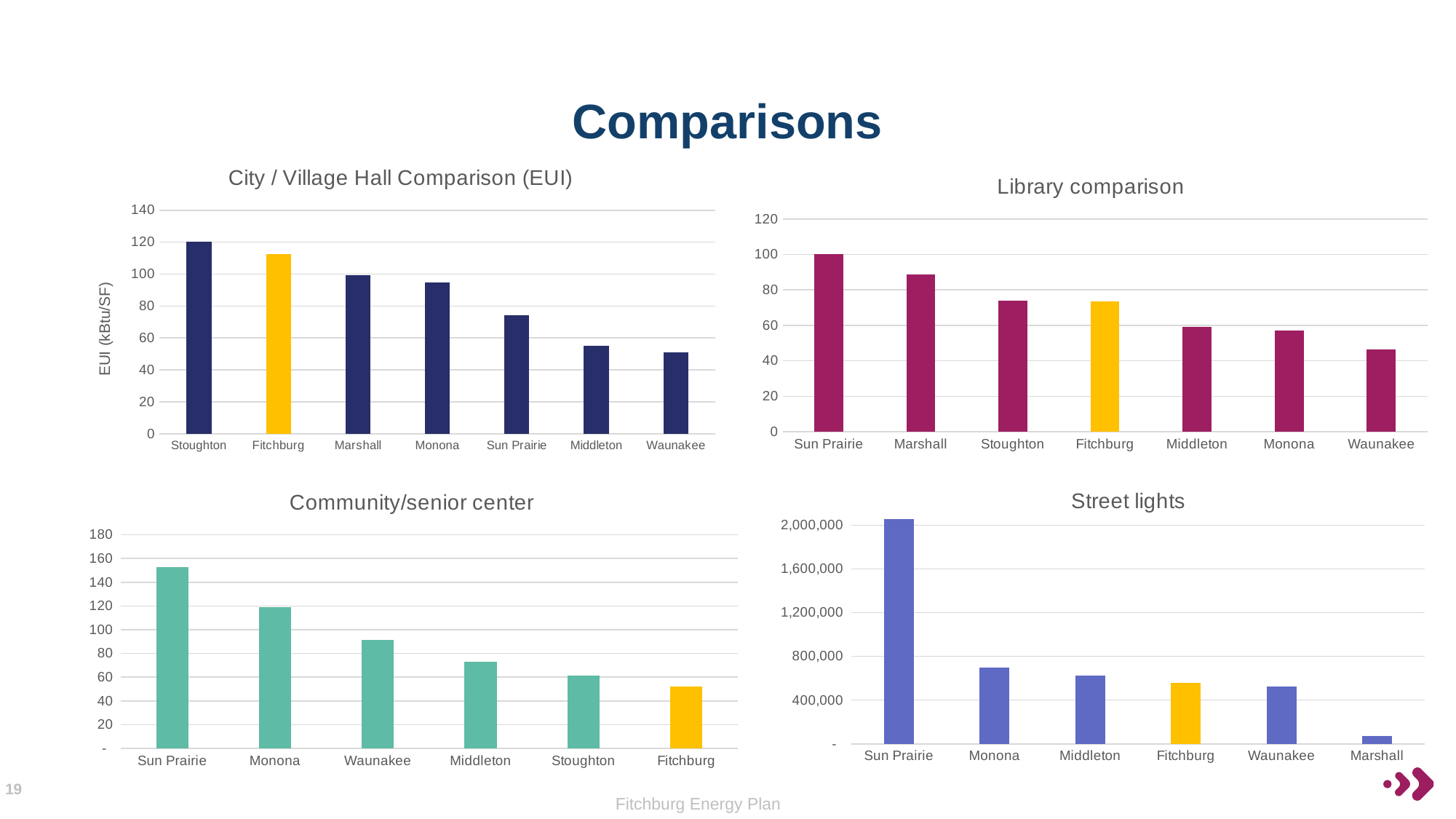
In the Library comparison chart, which municipality has the lowest value? Waunakee In the Community/senior center chart, do the values rise or fall from left to right along the x axis? fall How many municipalities are shown in the City / Village Hall Comparison (EUI) chart? 7 In the Library comparison chart, is the value for Marshall greater or less than 80? greater In the Community/senior center chart, is the value for Monona greater or less than 100? greater What type of chart is the Street lights chart? bar chart In the Street lights chart, which municipality has the highest value? Sun Prairie In the Library comparison chart, which is larger, the value for Sun Prairie or the value for Middleton? Sun Prairie What is the y-axis label of the City / Village Hall Comparison (EUI) chart? EUI (kBtu/SF) In the Street lights chart, is the value for Marshall greater or less than 400,000? less In the City / Village Hall Comparison (EUI) chart, which municipality has the highest value? Stoughton